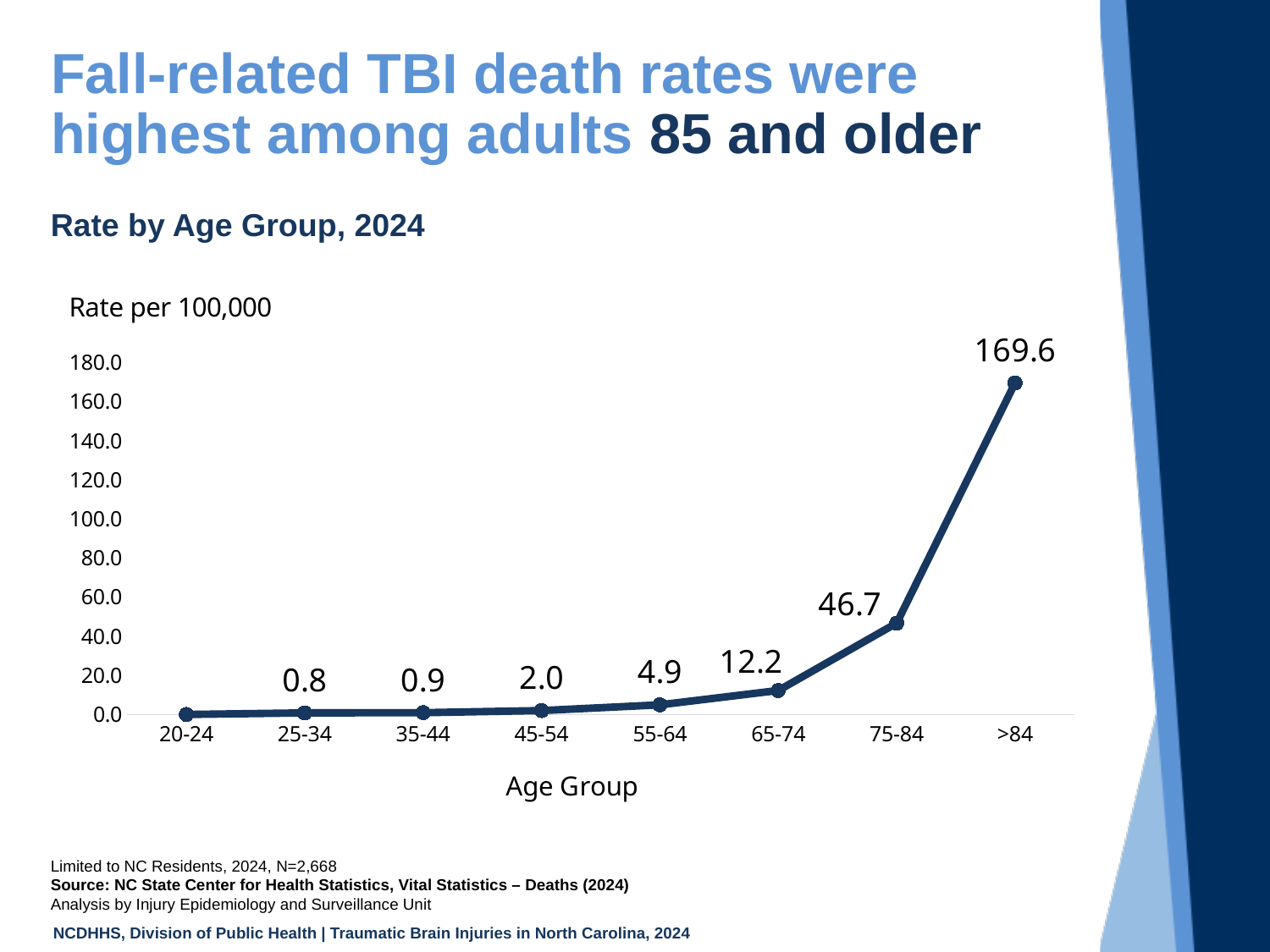
What is the rate for the 45-54 age group? 2.0 What is the rate for the 65-74 age group? 12.2 Do the rates rise or fall as age group increases along the x axis? rise Which age group has the highest fall-related TBI death rate? >84 What kind of chart is shown on the slide? line chart What is the difference between the rates for the 75-84 and 65-74 age groups? 34.5 Which age group has a higher rate, 55-64 or 65-74? 65-74 What is the fall-related TBI death rate for the >84 age group? 169.6 What is the difference between the rates for the >84 and 75-84 age groups? 122.9 What is the rate per 100,000 for the 75-84 age group? 46.7 How many age groups are plotted on the chart? 8 Is the value for the 20-24 age group greater or less than 20.0? less